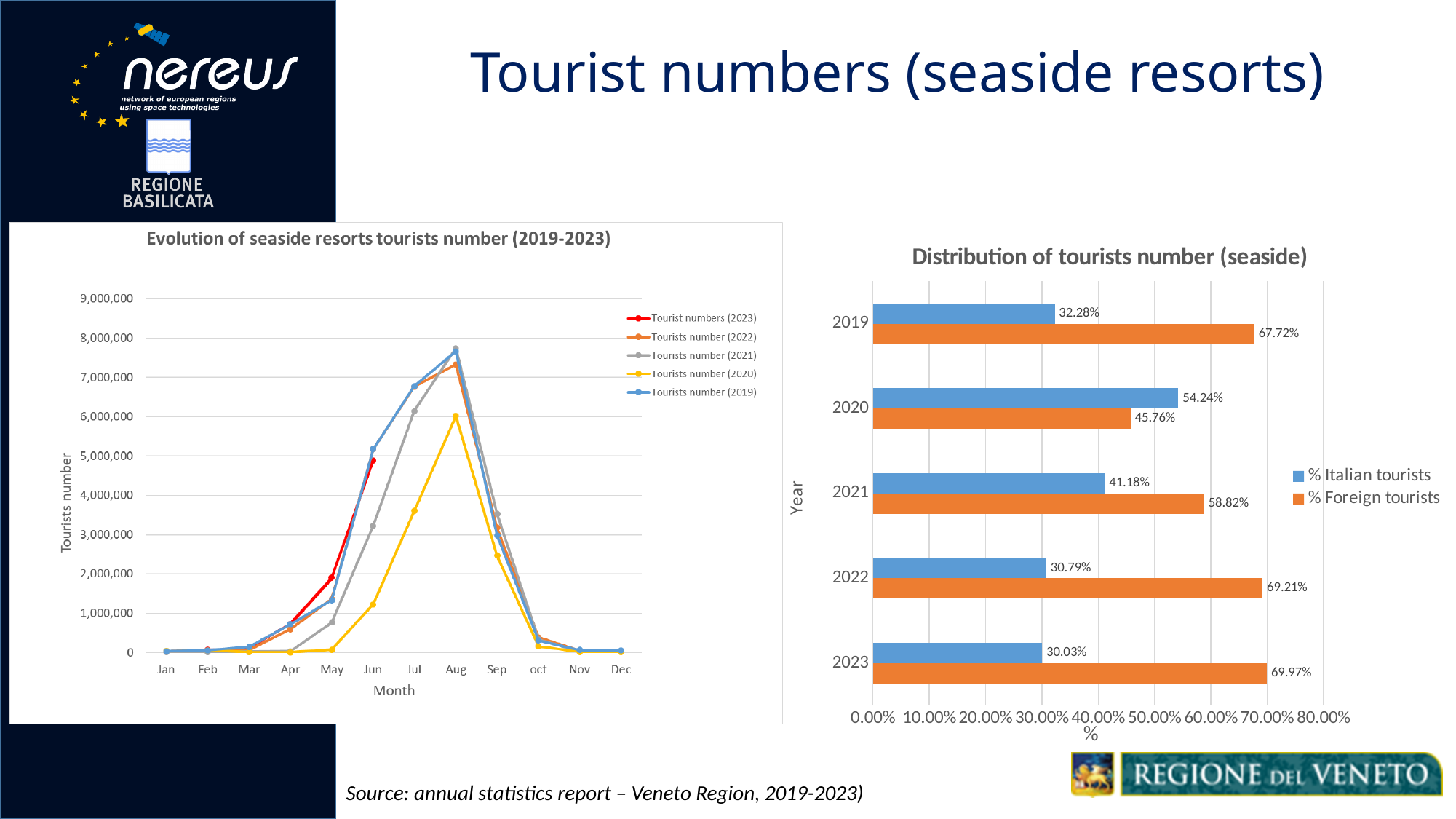
In the 'Distribution of tourists number (seaside)' chart, what is the percentage of Italian tourists in 2020? 54.24% In the 'Distribution of tourists number (seaside)' chart, which is larger in 2021: the share of Italian tourists or the share of foreign tourists? % Foreign tourists How many series does the legend of the 'Distribution of tourists number (seaside)' chart list? 2 How many series does the legend of the 'Evolution of seaside resorts tourists number (2019-2023)' chart list? 5 In the 'Distribution of tourists number (seaside)' chart, which year has the lowest share of foreign tourists? 2020 In the 'Evolution of seaside resorts tourists number (2019-2023)' chart, is the value for August 2020 greater or less than 7,000,000? less In the 'Distribution of tourists number (seaside)' chart, which year has the highest share of Italian tourists? 2020 In the 'Distribution of tourists number (seaside)' chart, what is the difference between the foreign and Italian tourist shares in 2019? 35.44% In the 'Distribution of tourists number (seaside)' chart, what is the percentage of foreign tourists in 2023? 69.97% What kind of chart is 'Evolution of seaside resorts tourists number (2019-2023)'? Line chart In the 'Evolution of seaside resorts tourists number (2019-2023)' chart, is the value for August 2021 greater or less than 7,000,000? greater How many years are shown in the 'Distribution of tourists number (seaside)' chart? 5